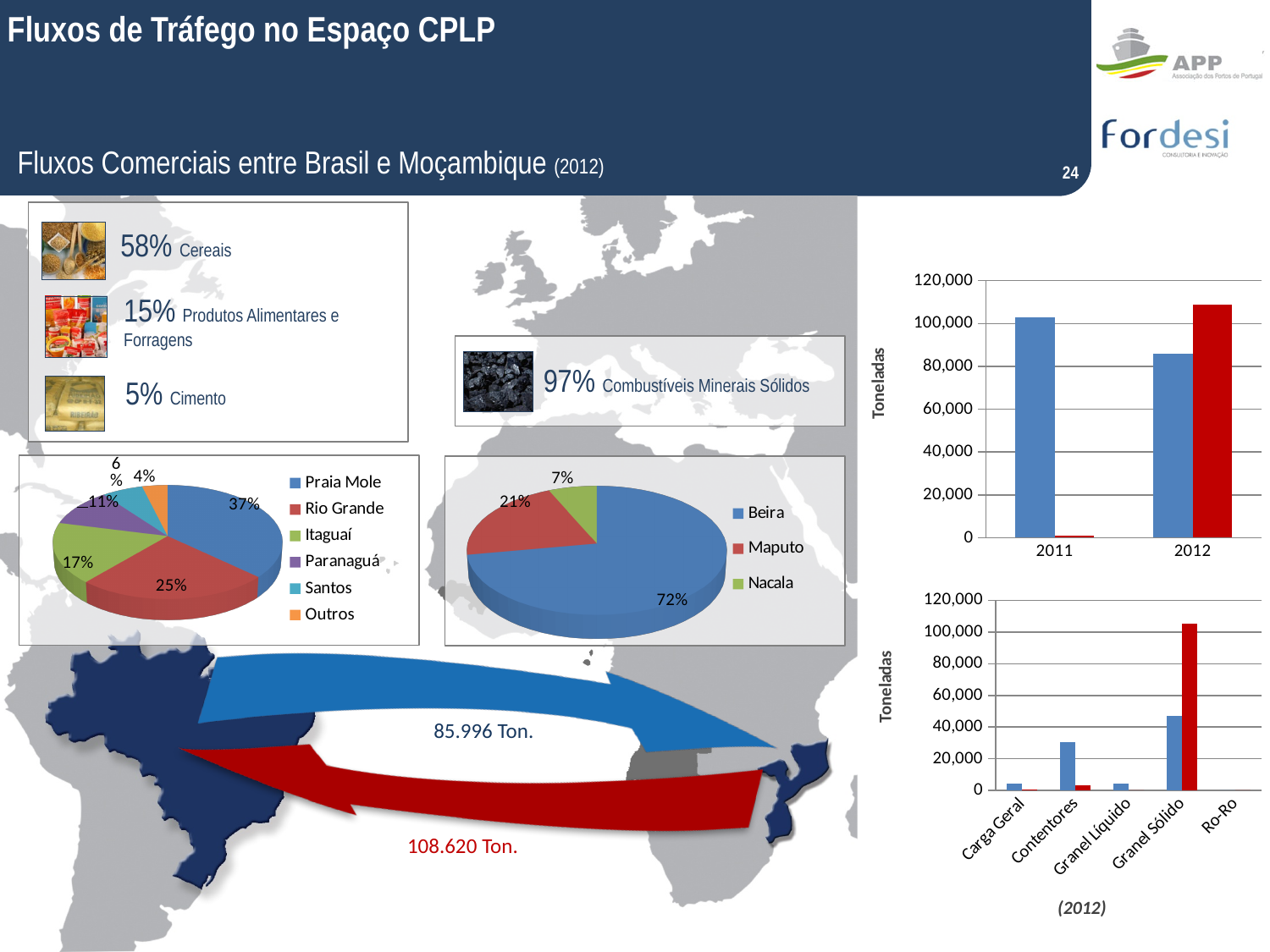
In the pie chart on the left (Praia Mole, Rio Grande, Itaguaí...), which port has the largest share? Praia Mole In the pie chart in the middle with the legend Beira, Maputo and Nacala, what share does Beira have? 72% In the pie chart on the left (Praia Mole, Rio Grande, Itaguaí...), what is the difference between the shares of Itaguaí and Paranaguá? 6% In the bottom-right bar chart by cargo type, how many categories are shown on the x axis? 5 In the pie chart in the middle (Beira, Maputo, Nacala), which port has the smallest share? Nacala In the pie chart on the left with the legend Praia Mole, Rio Grande, Itaguaí, Paranaguá, Santos and Outros, what share does Praia Mole have? 37% In the pie chart on the left (Praia Mole, Rio Grande, Itaguaí...), how many slices does the legend list? 6 In the top-right bar chart with years 2011 and 2012, which bar is taller in 2012, the blue one or the red one? the red one In the pie chart in the middle (Beira, Maputo, Nacala), what is the difference between the shares of Maputo and Nacala? 14% In the bottom-right bar chart by cargo type (Carga Geral, Contentores, ...), which category has the tallest bar? Granel Sólido In the pie chart on the left (Praia Mole, Rio Grande, Itaguaí...), what share does Rio Grande have? 25% In the top-right bar chart with years 2011 and 2012, is the blue bar for 2011 greater or less than 100,000 toneladas? greater